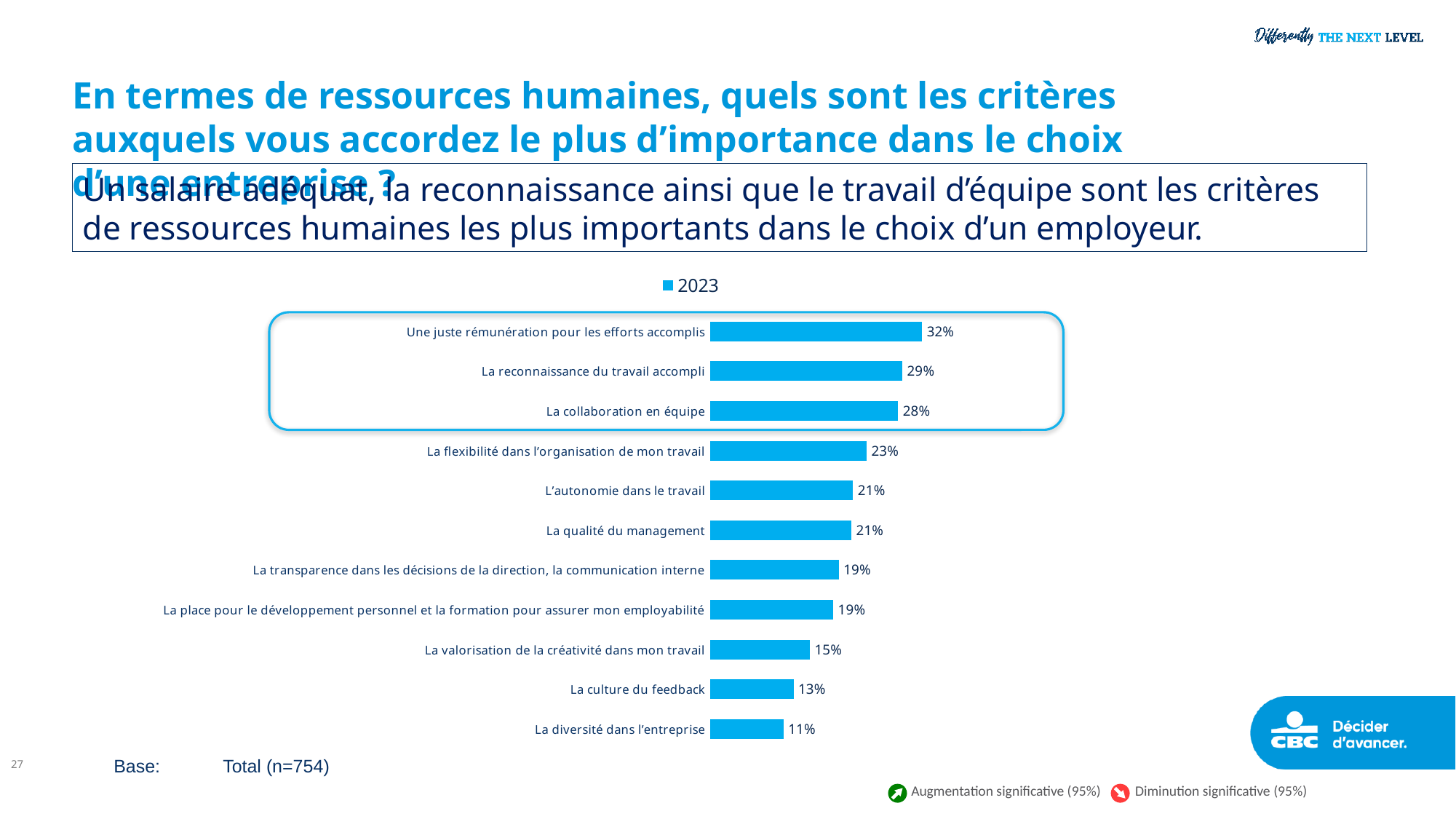
What is the value for "La collaboration en équipe"? 28% What is the difference between "La reconnaissance du travail accompli" and "La valorisation de la créativité dans mon travail"? 14% What kind of chart is shown on the slide? Bar chart What is the value for "Une juste rémunération pour les efforts accomplis"? 32% Which category has the lowest value? La diversité dans l'entreprise How many categories are shown in the chart? 11 Which category has the highest value? Une juste rémunération pour les efforts accomplis Which is larger: "La reconnaissance du travail accompli" or "L'autonomie dans le travail"? La reconnaissance du travail accompli What is the value for "La culture du feedback"? 13% What is the difference between "Une juste rémunération pour les efforts accomplis" and "La diversité dans l'entreprise"? 21% How many series does the legend list? 1 What is the value for "La flexibilité dans l'organisation de mon travail"? 23%